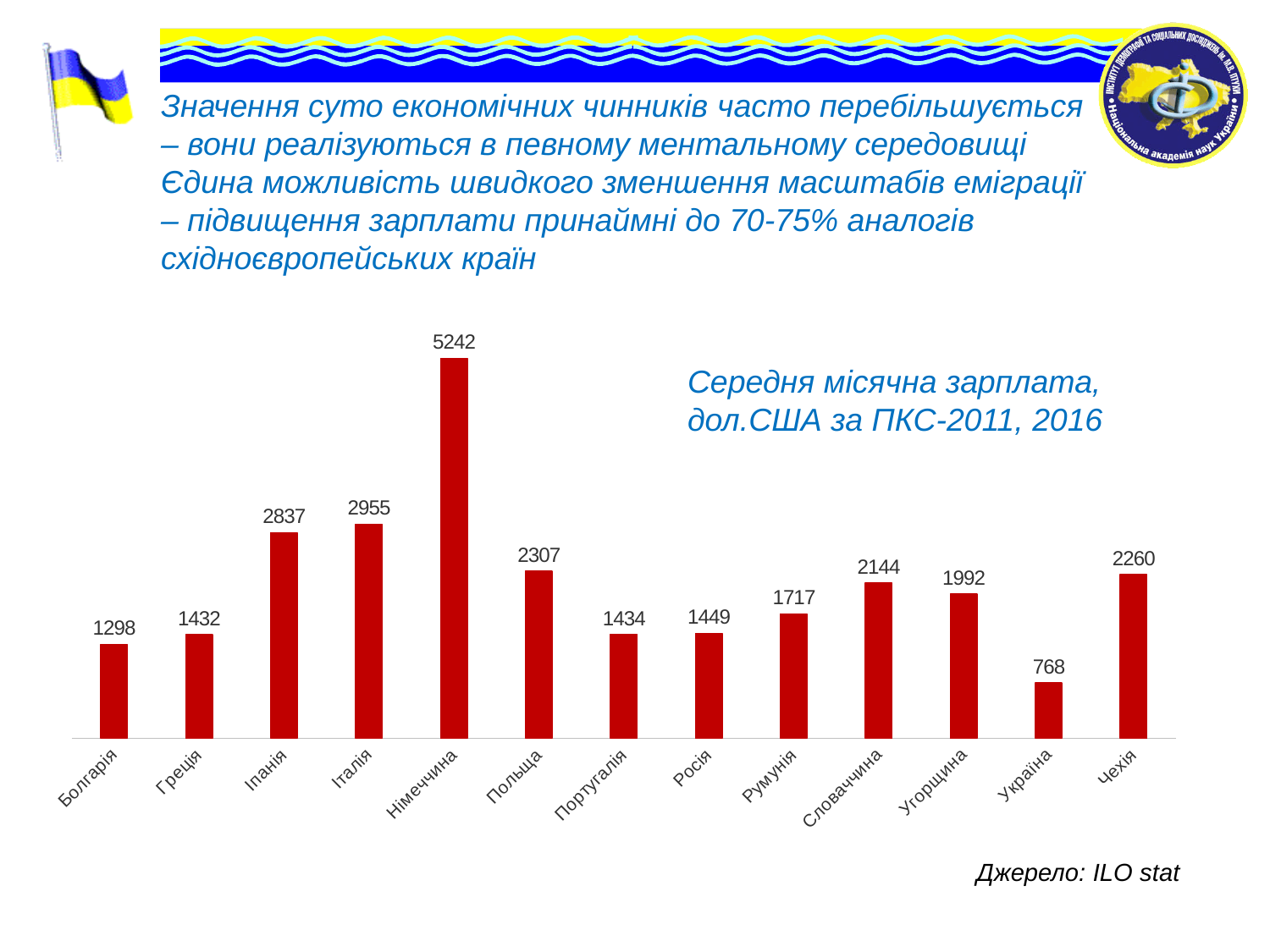
What is the average monthly wage shown for Україна? 768 What is the difference between the values for Італія and Іспанія? 118 What value is shown for Словаччина? 2144 What value is shown for Німеччина? 5242 How many countries are shown in the chart? 13 What type of chart is shown on the slide? Bar chart Which is larger, the value for Угорщина or the value for Румунія? Угорщина Which country has the lowest value in the chart? Україна What value is shown for Польща? 2307 What is the difference between the values for Чехія and Україна? 1492 Which country has the highest value in the chart? Німеччина What source is cited for the chart data? ILO stat